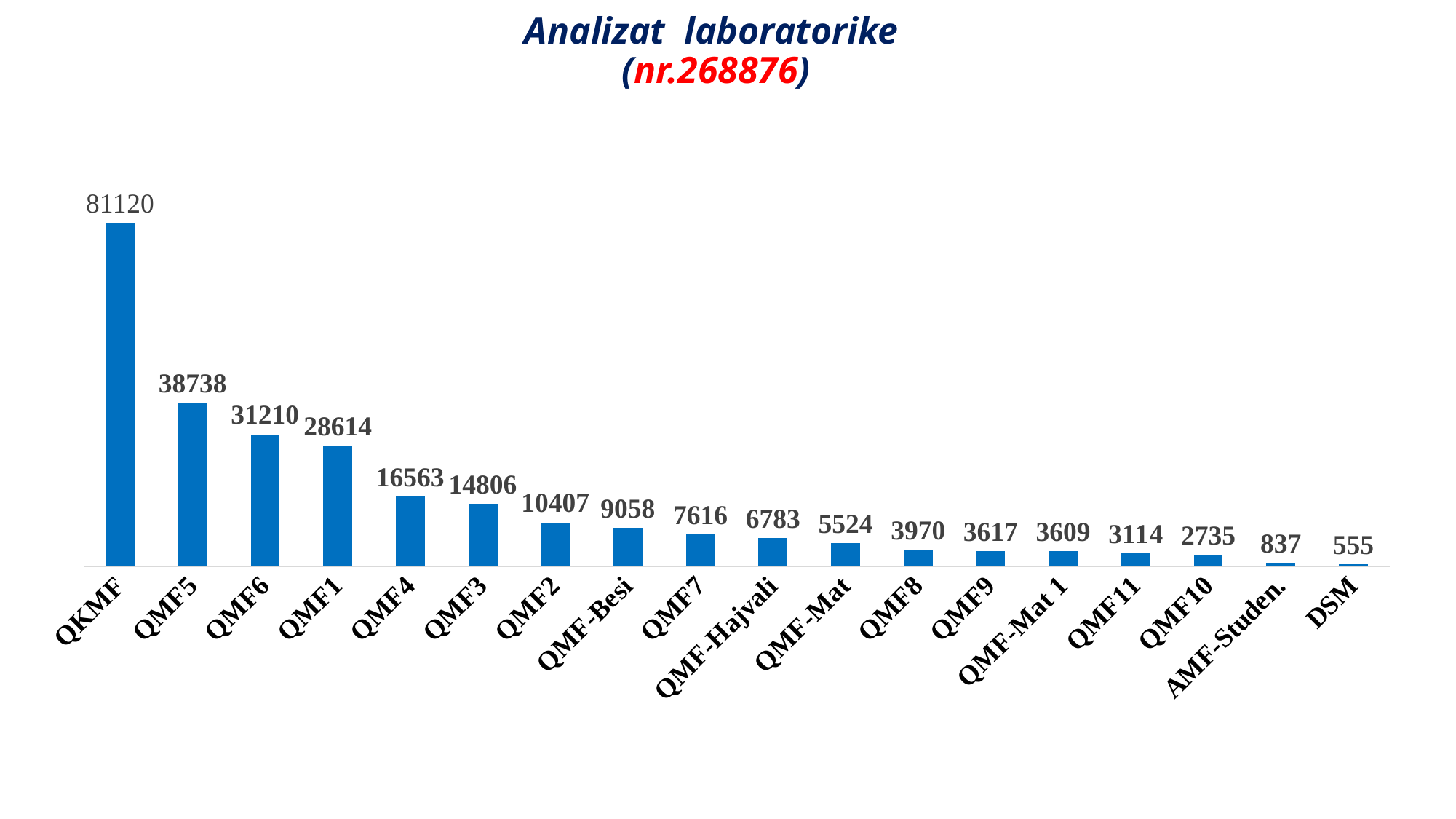
What kind of chart is this? Bar chart Which category has the highest value? QKMF How many categories are shown in the chart? 18 Which category has the lowest value? DSM Which is larger, the value for QMF4 or the value for QMF2? QMF4 What is the title of the chart? Analizat laboratorike (nr.268876) What is the difference between the values for QKMF and QMF5? 42382 What is the value for AMF-Studen.? 837 What is the value for QKMF? 81120 What is the difference between the values for QMF6 and QMF1? 2596 What is the value for QMF-Hajvali? 6783 Do the values rise or fall from left to right along the x axis? Fall